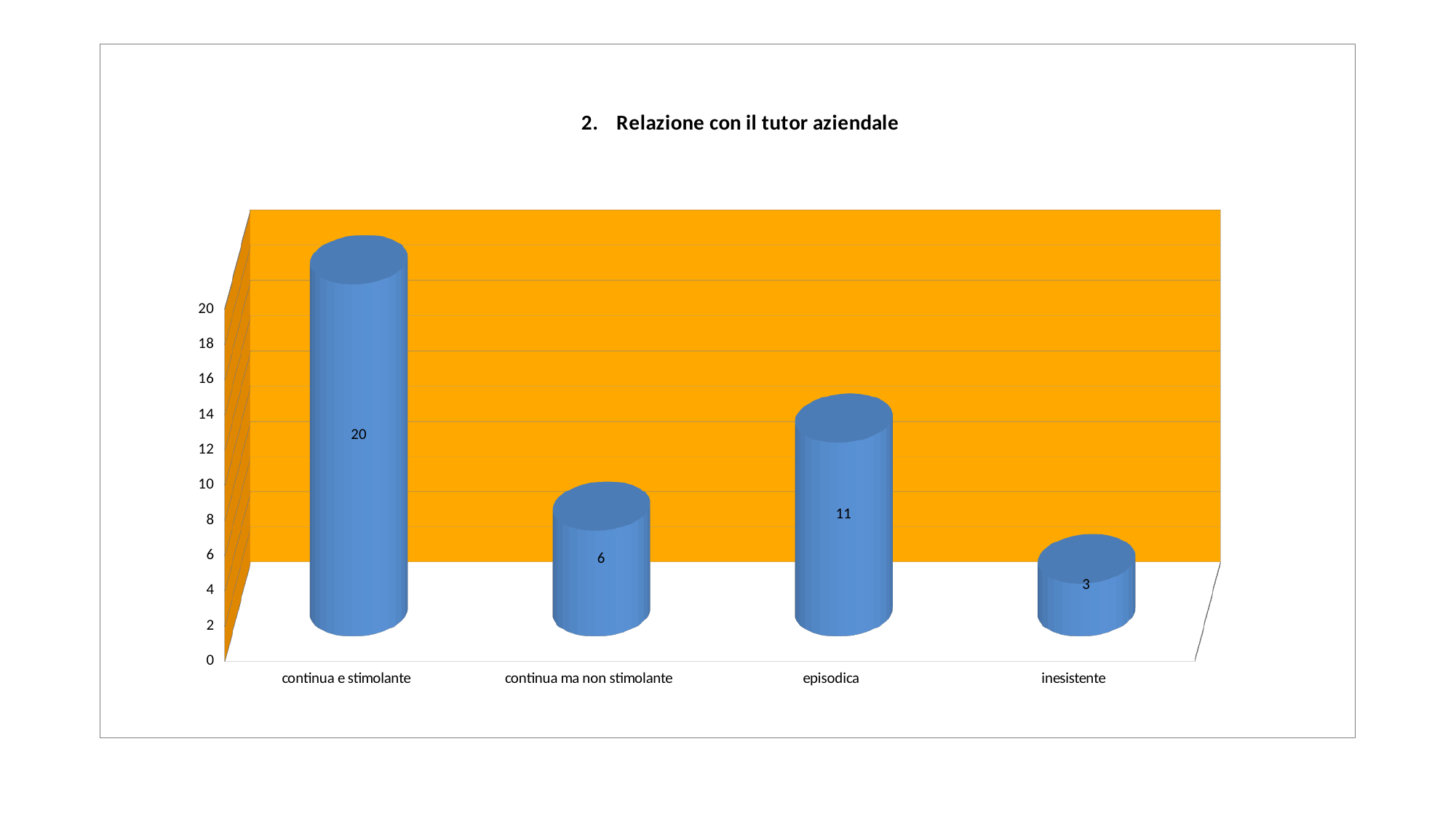
Which category has the highest value? continua e stimolante Which is larger, the value for "episodica" or the value for "continua ma non stimolante"? episodica Which category has the lowest value? inesistente What is the title of the chart? 2. Relazione con il tutor aziendale What is the value for "continua e stimolante"? 20 What is the difference between the values for "continua e stimolante" and "episodica"? 9 What is the value for "continua ma non stimolante"? 6 What is the value for "inesistente"? 3 What is the difference between the values for "continua ma non stimolante" and "inesistente"? 3 What kind of chart is shown on the slide? bar chart What is the value for "episodica"? 11 How many categories are shown on the x axis? 4